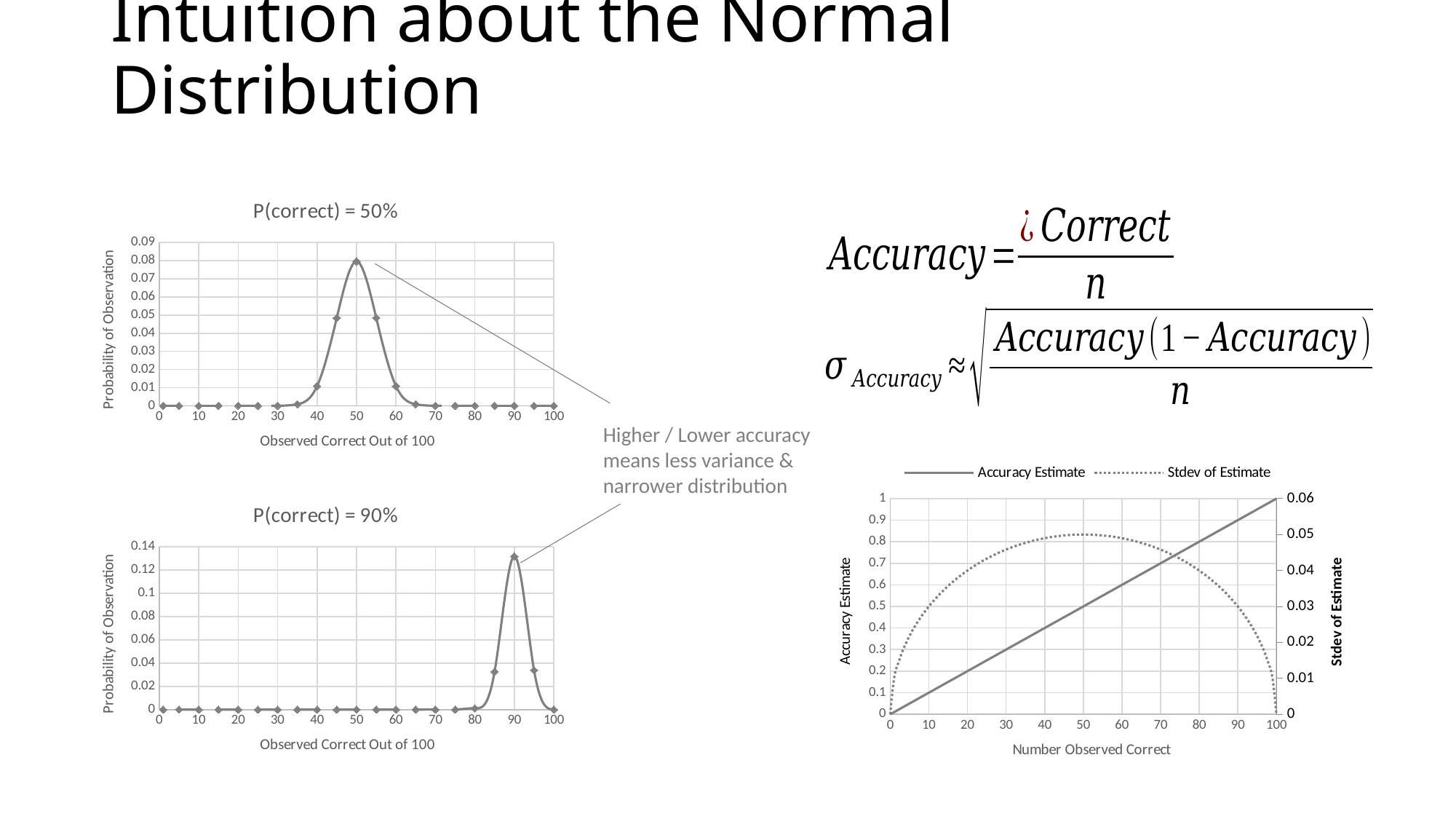
In the chart titled 'P(correct) = 50%', is the probability at 40 observed correct greater or less than 0.02? less In the bottom-right chart with the legend 'Accuracy Estimate' and 'Stdev of Estimate', what is the Stdev of Estimate when the Number Observed Correct is 50? 0.05 In the bottom-right chart, does the Accuracy Estimate rise or fall as the Number Observed Correct increases? rises In the chart titled 'P(correct) = 90%', is the probability at 50 observed correct greater or less than 0.02? less What kind of chart is the chart titled 'P(correct) = 50%'? line chart How many series does the legend of the bottom-right chart list? 2 In the chart titled 'P(correct) = 90%', is the probability at 90 observed correct greater or less than 0.1? greater In the bottom-right chart with the legend 'Accuracy Estimate' and 'Stdev of Estimate', what is the Accuracy Estimate when the Number Observed Correct is 50? 0.5 In the chart titled 'P(correct) = 90%', at which value of Observed Correct Out of 100 is the probability highest? 90 In the chart titled 'P(correct) = 50%', which has the higher probability: 50 observed correct or 40 observed correct? 50 observed correct In the chart titled 'P(correct) = 50%', at which value of Observed Correct Out of 100 is the probability highest? 50